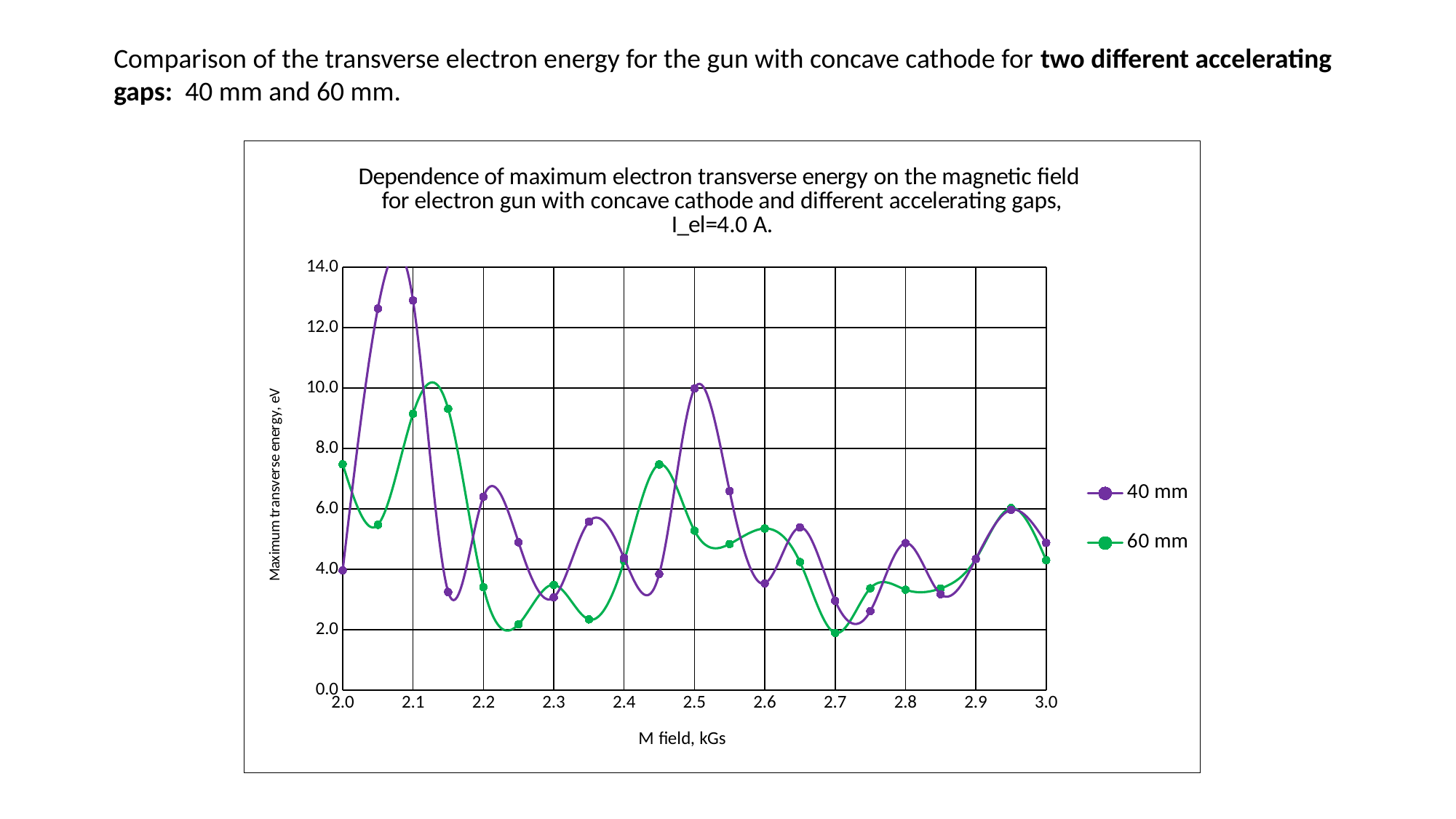
Does the 60 mm series rise or fall between 2.6 and 2.7 kGs? fall Is the value for the 60 mm series at 2.0 kGs greater or less than 6.0? greater Is the value for the 40 mm series at 2.05 kGs greater or less than 12.0? greater Is the value for the 60 mm series at 2.1 kGs greater or less than 8.0? greater What is the x-axis title of the chart? M field, kGs What kind of chart is shown on the slide? line chart At 2.0 kGs, which series has the larger value, 40 mm or 60 mm? 60 mm What are the two series named in the legend? 40 mm and 60 mm At which magnetic field value does the 60 mm series reach its highest point? 2.15 At 2.5 kGs, which series has the larger value, 40 mm or 60 mm? 40 mm How many series does the legend list? 2